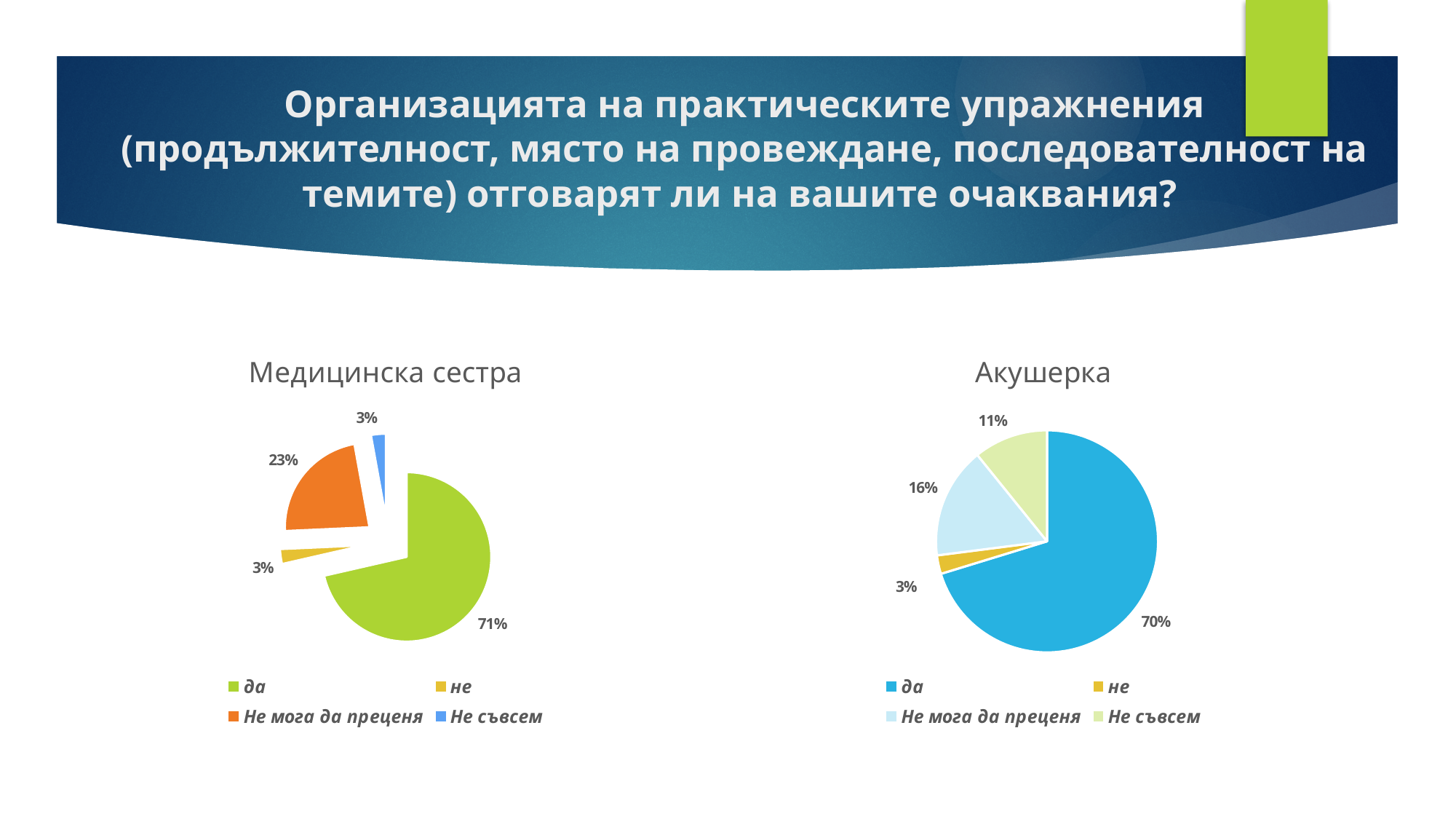
What type of chart is used for "Акушерка"? Pie chart Which chart has the larger "Не мога да преценя" share, "Медицинска сестра" or "Акушерка"? Медицинска сестра In the "Медицинска сестра" chart, which category has the largest slice? да In the "Акушерка" chart, what percentage is shown for "да"? 70% In the "Медицинска сестра" chart, what is the difference between the "да" and "Не мога да преценя" slices? 48% In the "Медицинска сестра" chart, what percentage is shown for "да"? 71% In the "Акушерка" chart, what is the difference between the "Не мога да преценя" and "Не съвсем" slices? 5% In the "Медицинска сестра" chart, what percentage is shown for "Не мога да преценя"? 23% In the "Акушерка" chart, what percentage is shown for "Не мога да преценя"? 16% In the "Акушерка" chart, which category has the smallest slice? не In the "Акушерка" chart, what percentage is shown for "Не съвсем"? 11% How many categories does the legend of the "Медицинска сестра" chart list? 4